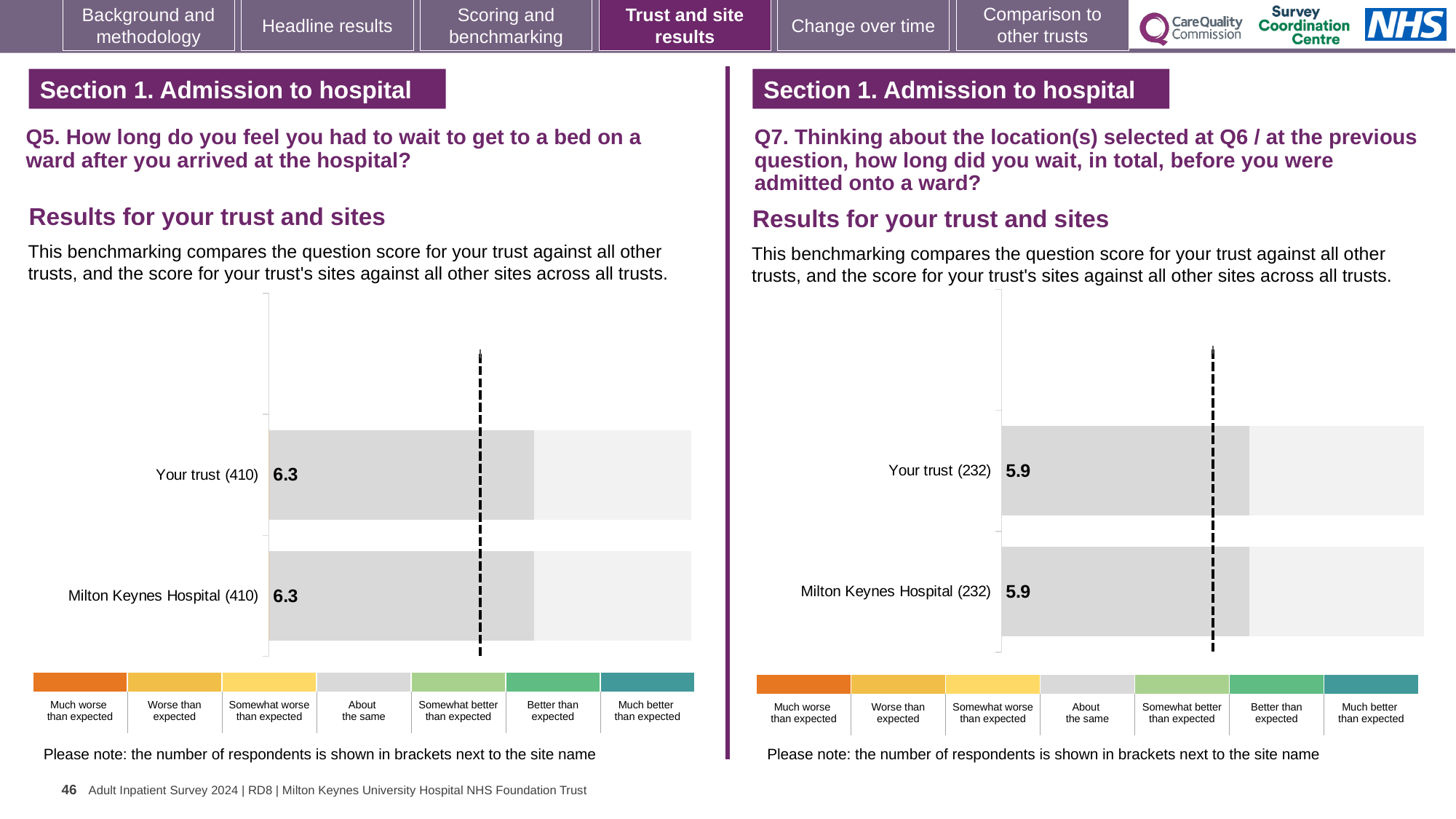
On the right chart (Q7), what is the score for Your trust? 5.9 How many bars are plotted on the left chart (Q5)? 2 On the right chart (Q7), what is the score for Milton Keynes Hospital? 5.9 On the right chart (Q7), what is the difference between the score for Your trust and the score for Milton Keynes Hospital? 0 How many bars are plotted on the right chart (Q7)? 2 On the left chart (Q5), how many respondents are shown in brackets for Your trust? 410 What kind of chart is used on the left (Q5) to show the results for your trust and sites? Bar chart On the left chart (Q5), what is the score for Milton Keynes Hospital? 6.3 How many benchmark categories does the colour key below the right chart (Q7) list? 7 On the left chart (Q5), what is the score for Your trust? 6.3 On the left chart (Q5), what is the difference between the score for Your trust and the score for Milton Keynes Hospital? 0 On the right chart (Q7), how many respondents are shown in brackets for Milton Keynes Hospital? 232